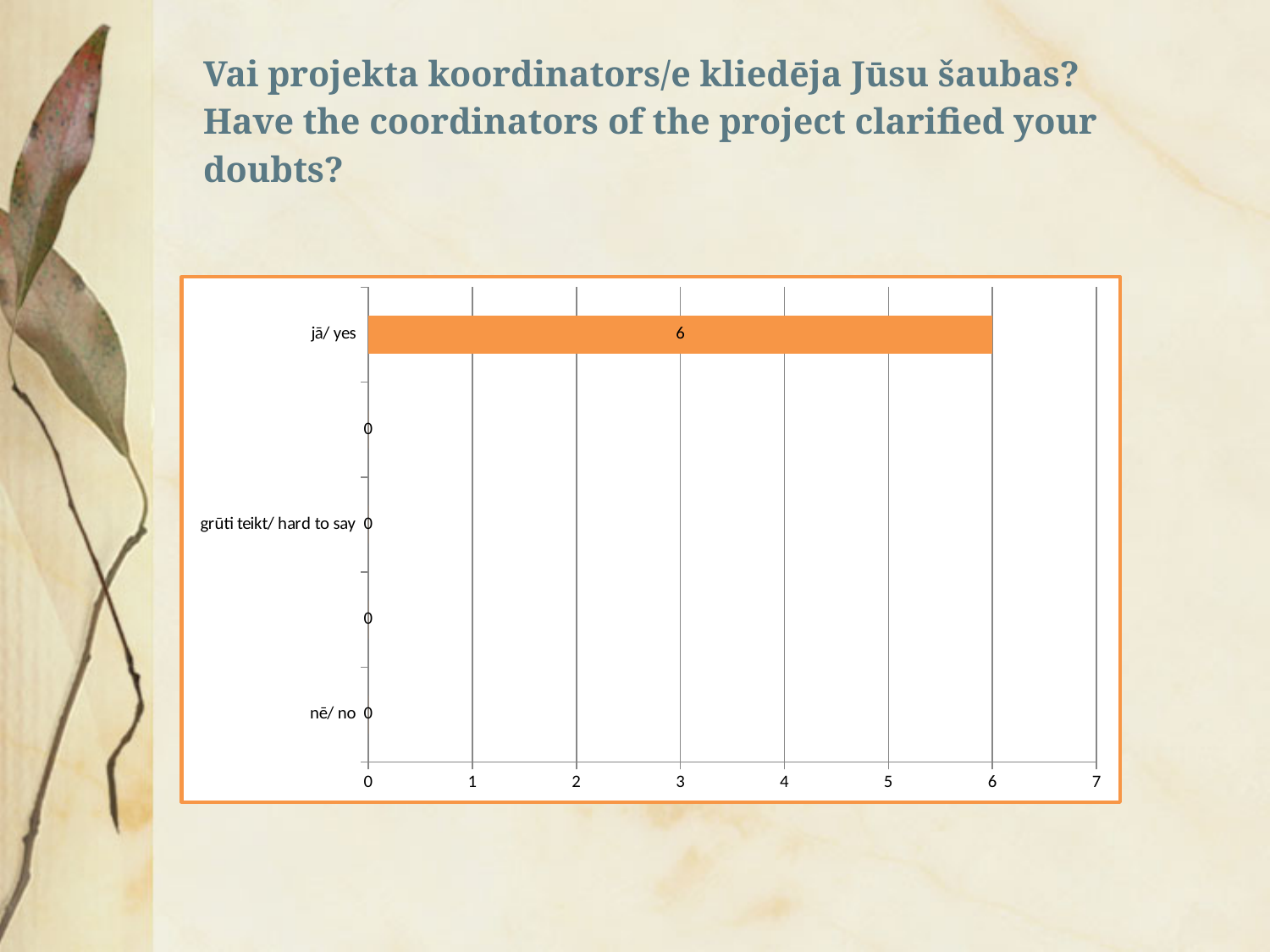
What is the value for "grūti teikt/ hard to say"? 0 How many data labels on the chart show a value of 0? 4 What is the difference between the values for "jā/ yes" and "nē/ no"? 6 Which is larger, the value for "jā/ yes" or the value for "grūti teikt/ hard to say"? jā/ yes What is the total of all the values shown on the chart? 6 What is the value for "nē/ no"? 0 What kind of chart is shown on the slide? bar chart Is the value for "jā/ yes" greater or less than 5? greater What is the highest value shown on the horizontal axis? 7 What is the value for "jā/ yes"? 6 Which category has the highest value? jā/ yes What colour is the bar for "jā/ yes"? orange